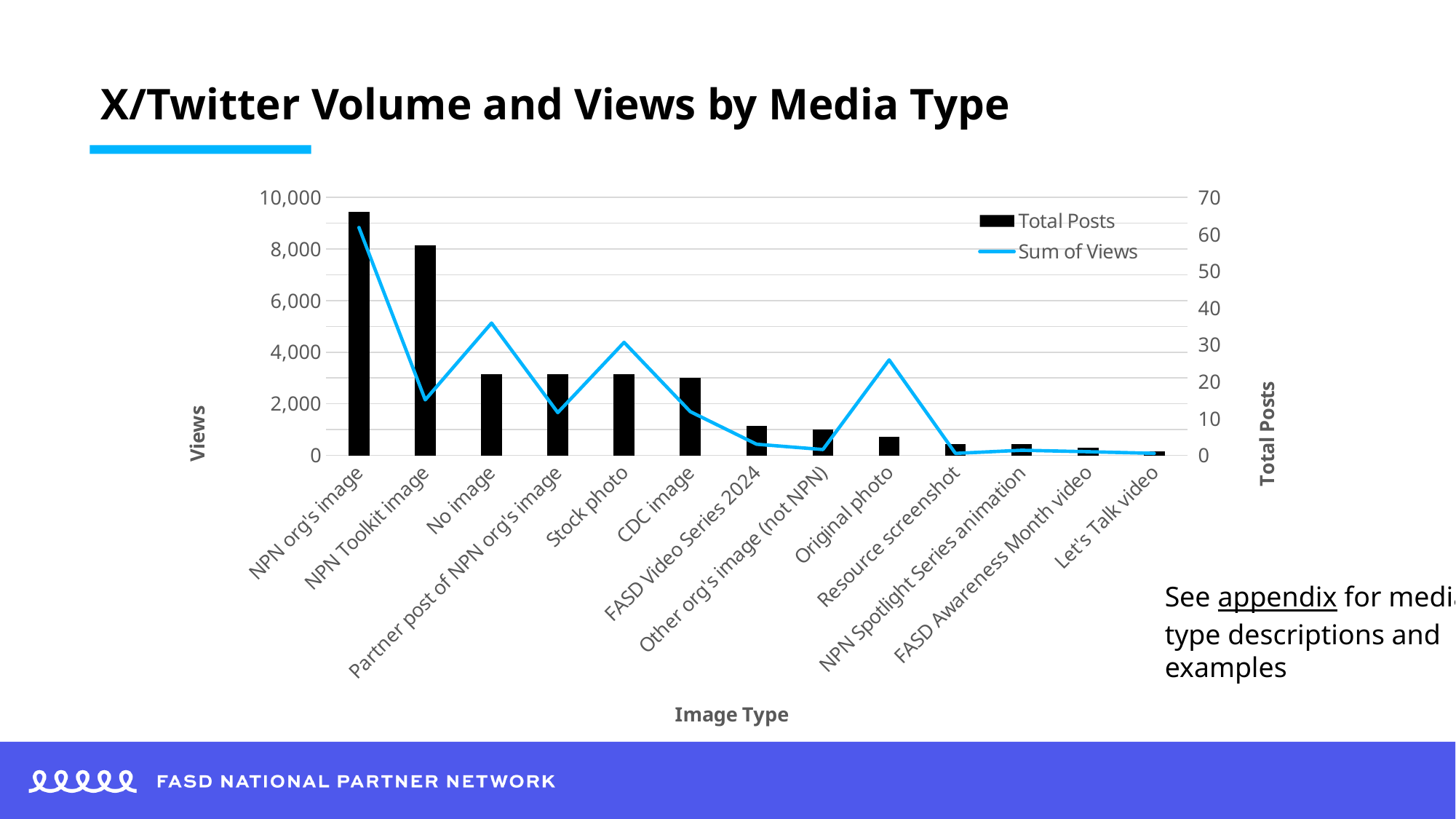
Is the Sum of Views for No image greater or less than 4,000? greater How many series does the legend list? 2 How many image type categories are shown on the x axis? 13 Which image type has the highest Sum of Views? NPN org's image Is the Sum of Views for NPN Toolkit image greater or less than 4,000? less Do the Total Posts bars generally rise or fall from left to right along the x axis? fall Which has more Total Posts, NPN org's image or NPN Toolkit image? NPN org's image Which image type has the highest Total Posts? NPN org's image Which has a higher Sum of Views, Original photo or Resource screenshot? Original photo What kind of chart is shown on the slide? A combination bar and line chart Is the Total Posts value for NPN org's image greater or less than 60? greater Which image type has the lowest Total Posts? Let's Talk video